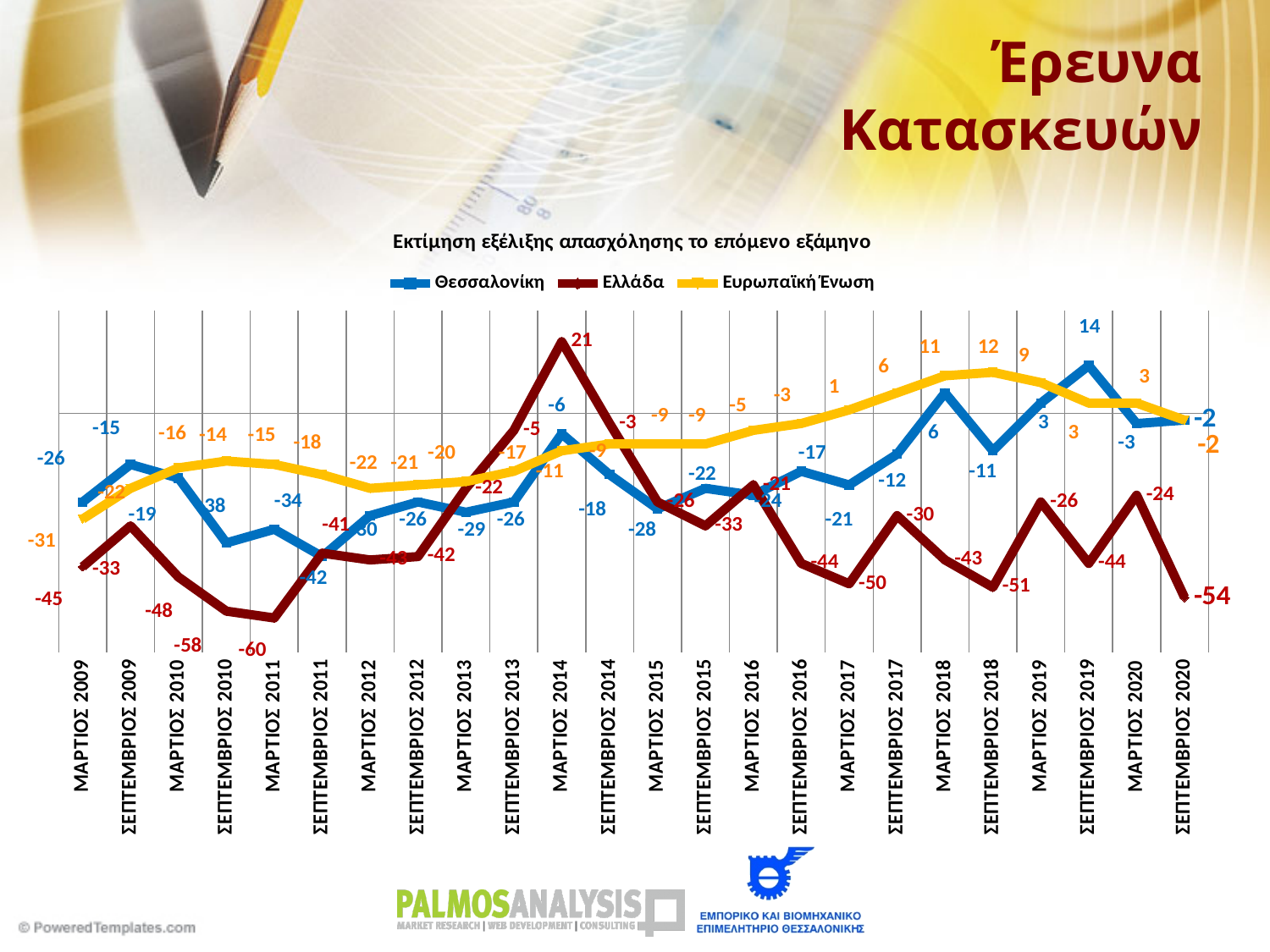
What is the title of the chart? Εκτίμηση εξέλιξης απασχόλησης το επόμενο εξάμηνο In which period does the Ελλάδα series reach its lowest value? ΜΑΡΤΙΟΣ 2011 What is the value for Ελλάδα in ΜΑΡΤΙΟΣ 2014? 21 How many series does the legend list? 3 What is the value for Θεσσαλονίκη in ΣΕΠΤΕΜΒΡΙΟΣ 2019? 14 What type of chart is shown on the slide? line chart In ΣΕΠΤΕΜΒΡΙΟΣ 2020, which is larger: the value for Θεσσαλονίκη or the value for Ελλάδα? Θεσσαλονίκη What is the value for Ελλάδα in ΣΕΠΤΕΜΒΡΙΟΣ 2020? -54 What is the difference between the Ελλάδα value in ΜΑΡΤΙΟΣ 2014 and its value in ΣΕΠΤΕΜΒΡΙΟΣ 2020? 75 In which period does the Θεσσαλονίκη series reach its highest value? ΣΕΠΤΕΜΒΡΙΟΣ 2019 How many time points are plotted along the x axis? 24 What is the value for Ευρωπαϊκή Ένωση in ΣΕΠΤΕΜΒΡΙΟΣ 2018? 12